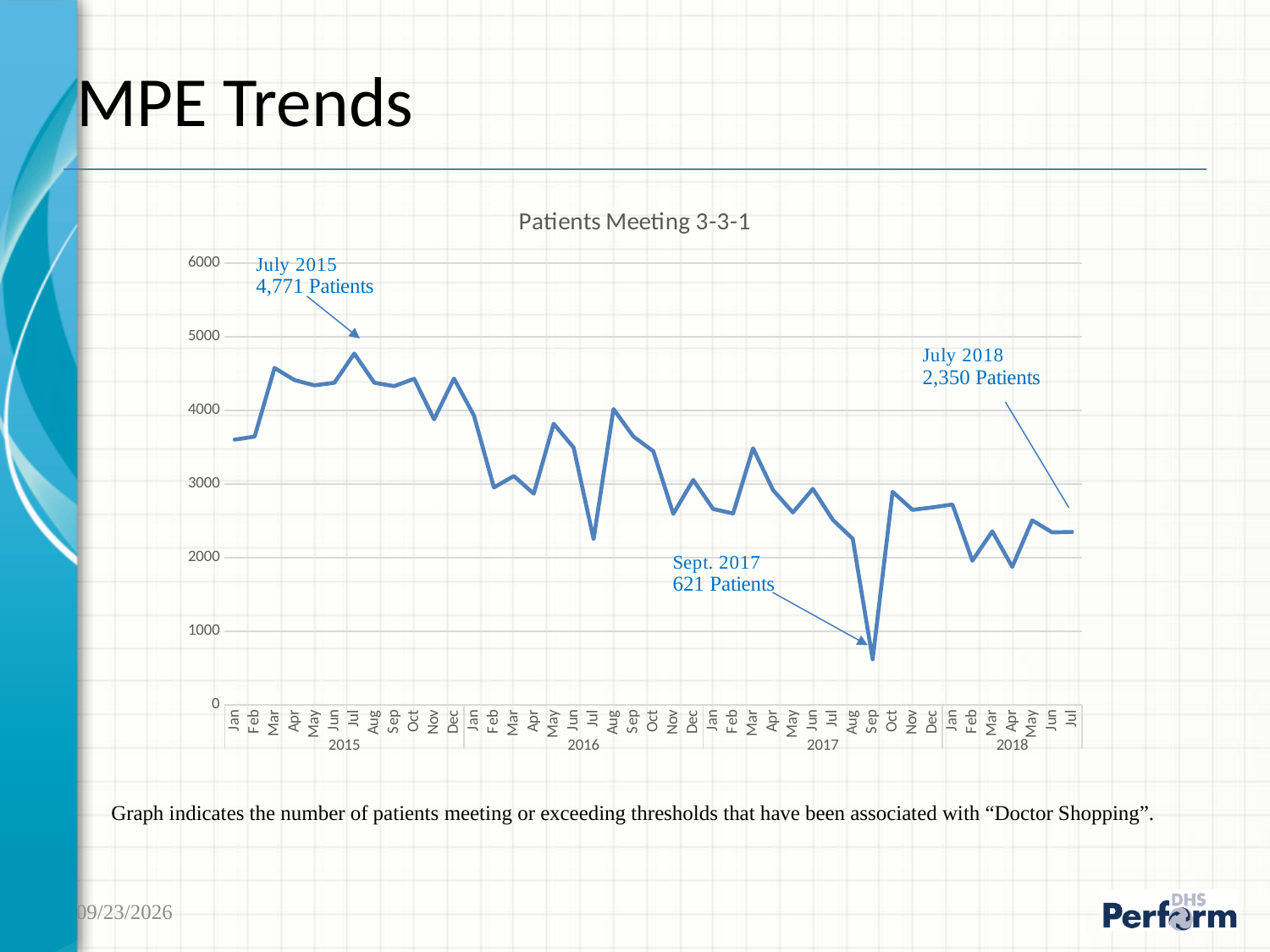
How many patients met the 3-3-1 threshold in Sept. 2017? 621 In which month is the number of patients highest? July 2015 How many patients met the 3-3-1 threshold in July 2018? 2,350 Overall, do the values rise or fall from Jan 2015 to Jul 2018? Fall How many monthly data points are plotted on the chart? 43 How many patients met the 3-3-1 threshold in July 2015? 4,771 What is the title of the chart? Patients Meeting 3-3-1 In which month is the number of patients lowest? Sept. 2017 Is the value for Jan 2015 greater or less than 4000? less What is the difference between the July 2015 and Sept. 2017 patient counts? 4,150 What kind of chart is shown on the slide? Line chart What is the difference between the July 2015 and July 2018 patient counts? 2,421